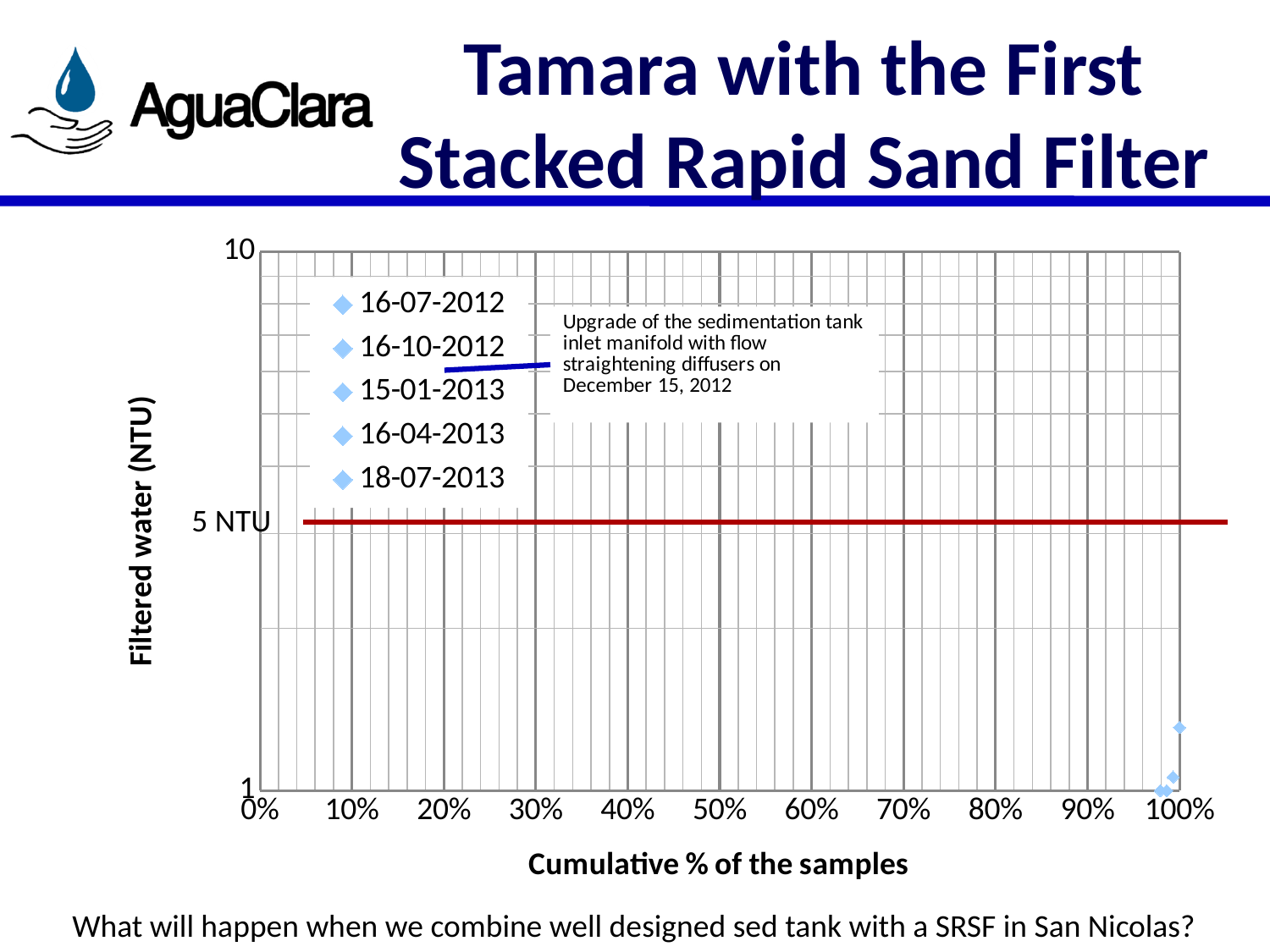
What is the title of the chart's x axis? Cumulative % of the samples Are the plotted data points on the chart above or below the 5 NTU line? Below What value does the red horizontal reference line on the chart mark? 5 NTU What is the highest value shown on the chart's y axis? 10 How many series does the chart legend list? 5 What is the title of the chart's y axis? Filtered water (NTU) What is the lowest value shown on the chart's y axis? 1 Near which x-axis value do the visible data points on the chart appear? 100% What kind of chart is shown on the slide? Scatter chart What is the last date listed in the chart legend? 18-07-2013 According to the annotation on the chart, on what date was the sedimentation tank inlet manifold upgraded? December 15, 2012 What is the first date listed in the chart legend? 16-07-2012